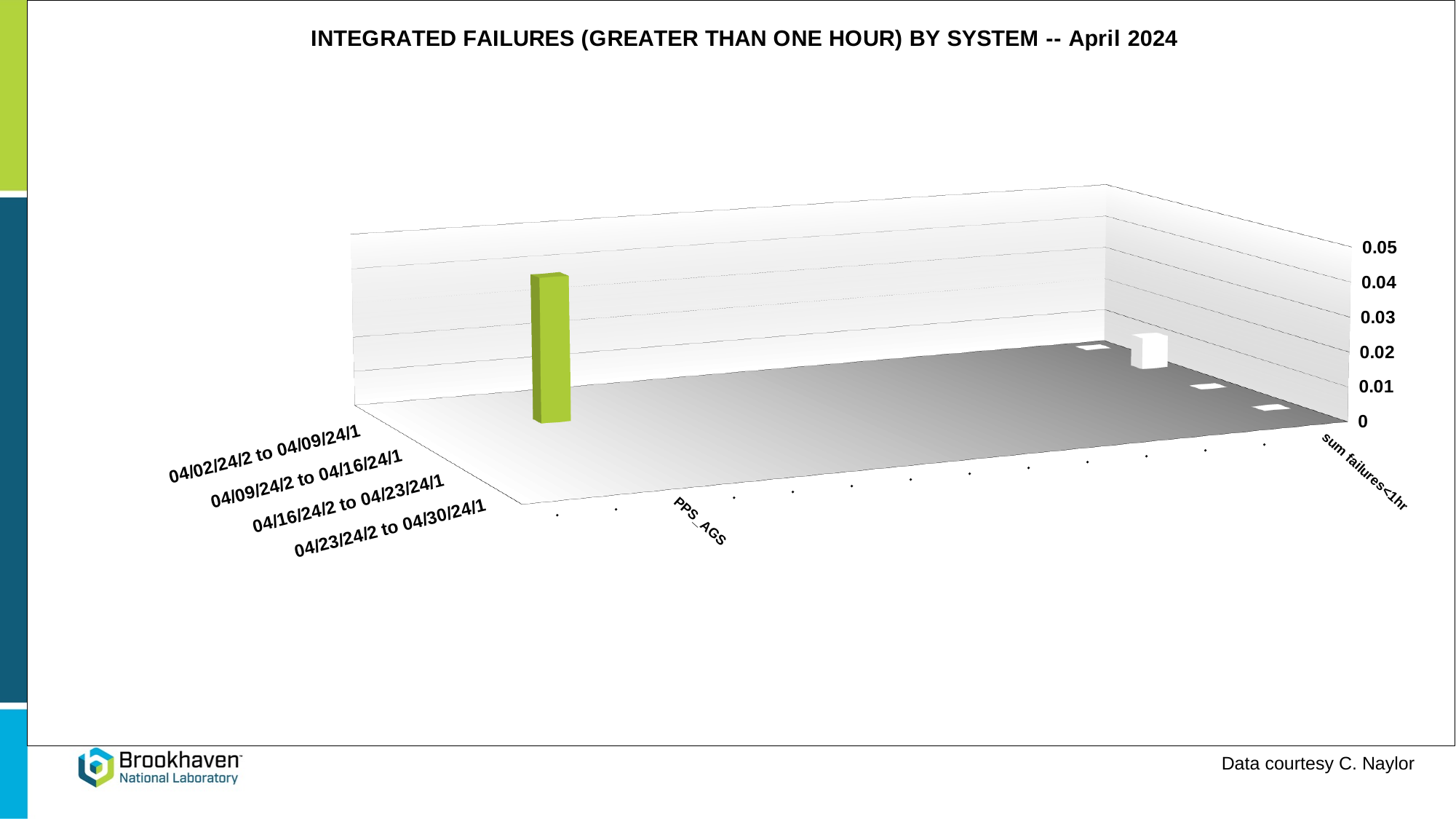
What kind of chart is shown on the slide? bar chart What is the title of the chart? INTEGRATED FAILURES (GREATER THAN ONE HOUR) BY SYSTEM -- April 2024 What is the highest tick value shown on the vertical axis of the chart? 0.05 Which date range has the tall green bar for PPS_AGS? 04/09/24/2 to 04/16/24/1 Which system label is readable on the front axis of the chart where the tall green bar is plotted? PPS_AGS How many weekly date-range categories are listed along the left axis of the chart? 4 Is the value of the green PPS_AGS bar greater or less than 0.05? less Is the value of the green PPS_AGS bar greater or less than 0.01? greater